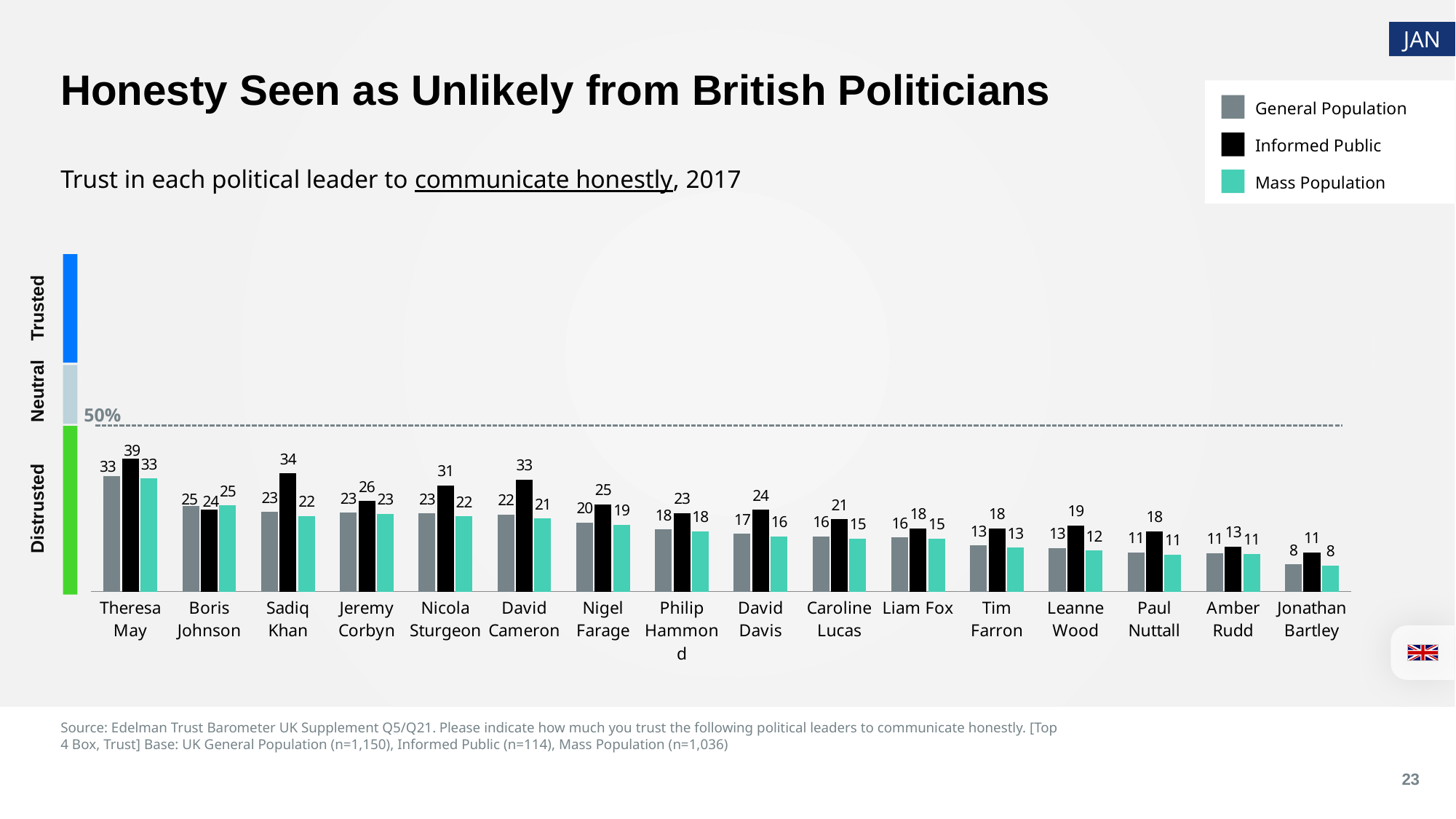
What kind of chart is shown on the slide? bar chart Which political leader has the highest Informed Public value? Theresa May How many political leaders are shown on the chart? 16 Is the Informed Public value for Theresa May greater or less than 50%? less Which is larger: the Informed Public value for David Cameron or the Informed Public value for Nicola Sturgeon? David Cameron What is the Informed Public value for Theresa May? 39 What is the Mass Population value for David Cameron? 21 What is the difference between the Informed Public and General Population values for Sadiq Khan? 11 What is the General Population value for Sadiq Khan? 23 Which political leader has the lowest General Population value? Jonathan Bartley What is the Informed Public value for Leanne Wood? 19 How many series does the legend list? 3